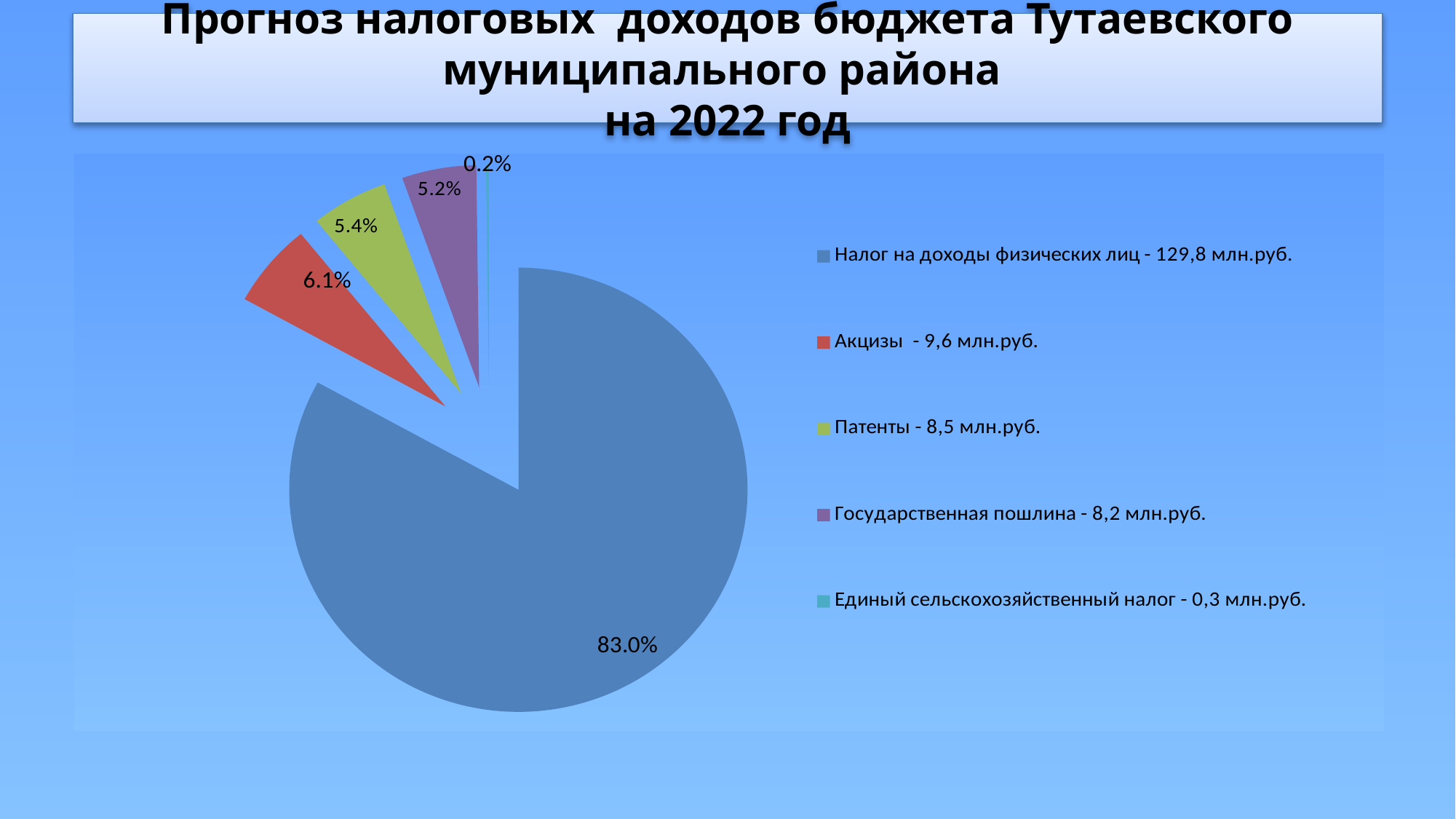
Which category has the largest slice of the pie? Налог на доходы физических лиц What share of the pie does Государственная пошлина take? 5.2% What kind of chart is shown on the slide? pie chart What share of the pie does Налог на доходы физических лиц take? 83.0% What share of the pie does Акцизы take? 6.1% According to the legend, what is the forecast amount for Налог на доходы физических лиц? 129,8 млн.руб. According to the legend, what is the forecast amount for Акцизы? 9,6 млн.руб. How many slices does the pie chart have? 5 Which category has the smallest slice of the pie? Единый сельскохозяйственный налог What is the difference in percentage points between the Акцизы slice and the Патенты slice? 0.7%